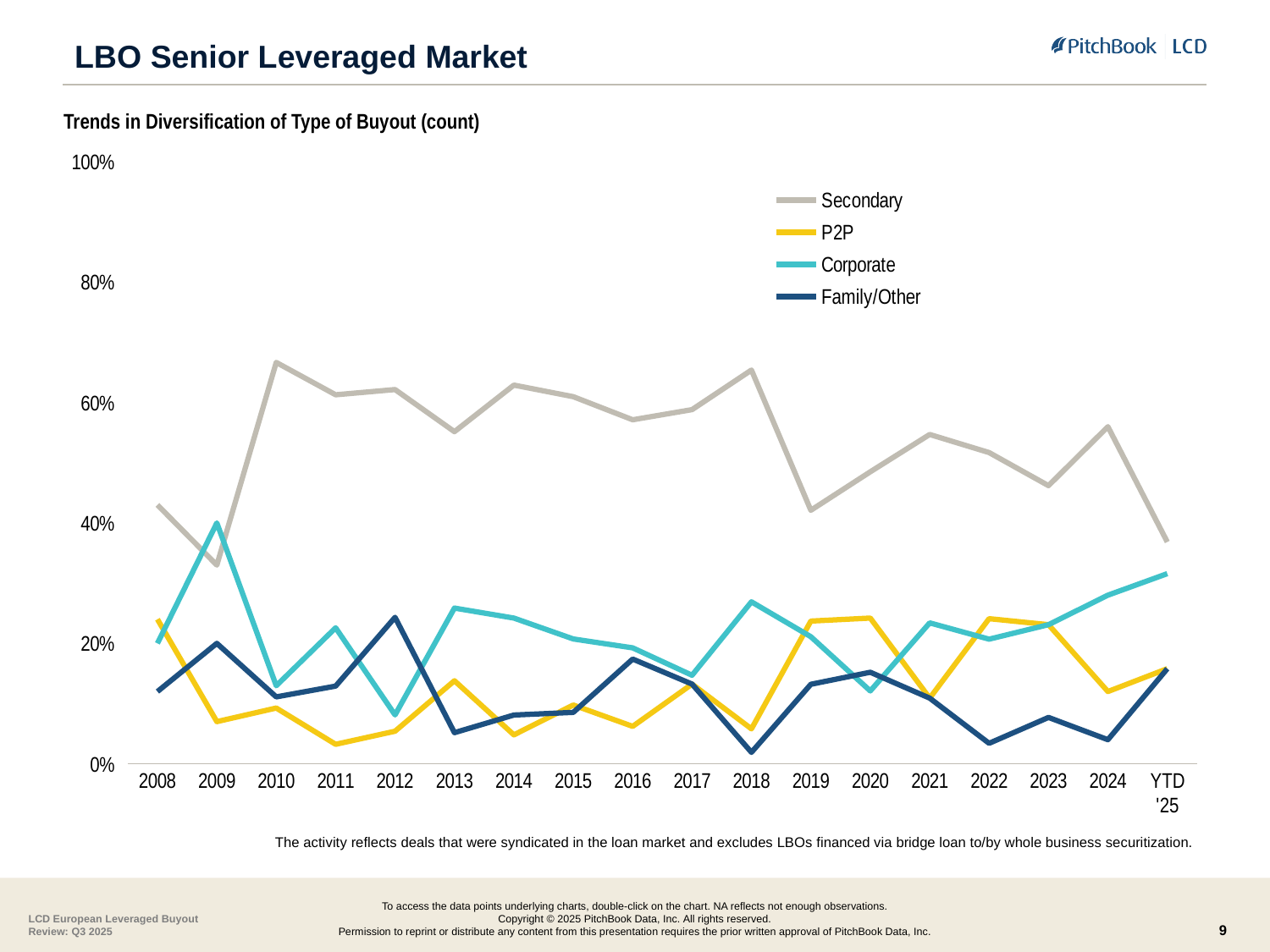
Which series has the highest value in 2016? Secondary Which series is shown in grey in the legend? Secondary Is the value for Secondary in YTD '25 greater or less than 40%? less Which is larger in 2009, the value for Corporate or the value for P2P? Corporate Is the value for Family/Other in 2018 greater or less than 20%? less What is the title of the chart? Trends in Diversification of Type of Buyout (count) Which series has the lowest value in 2018? Family/Other What kind of chart is shown on the slide? Line chart How many series does the legend list? 4 Is the value for Secondary in 2010 greater or less than 60%? greater How many time periods are plotted along the x axis? 18